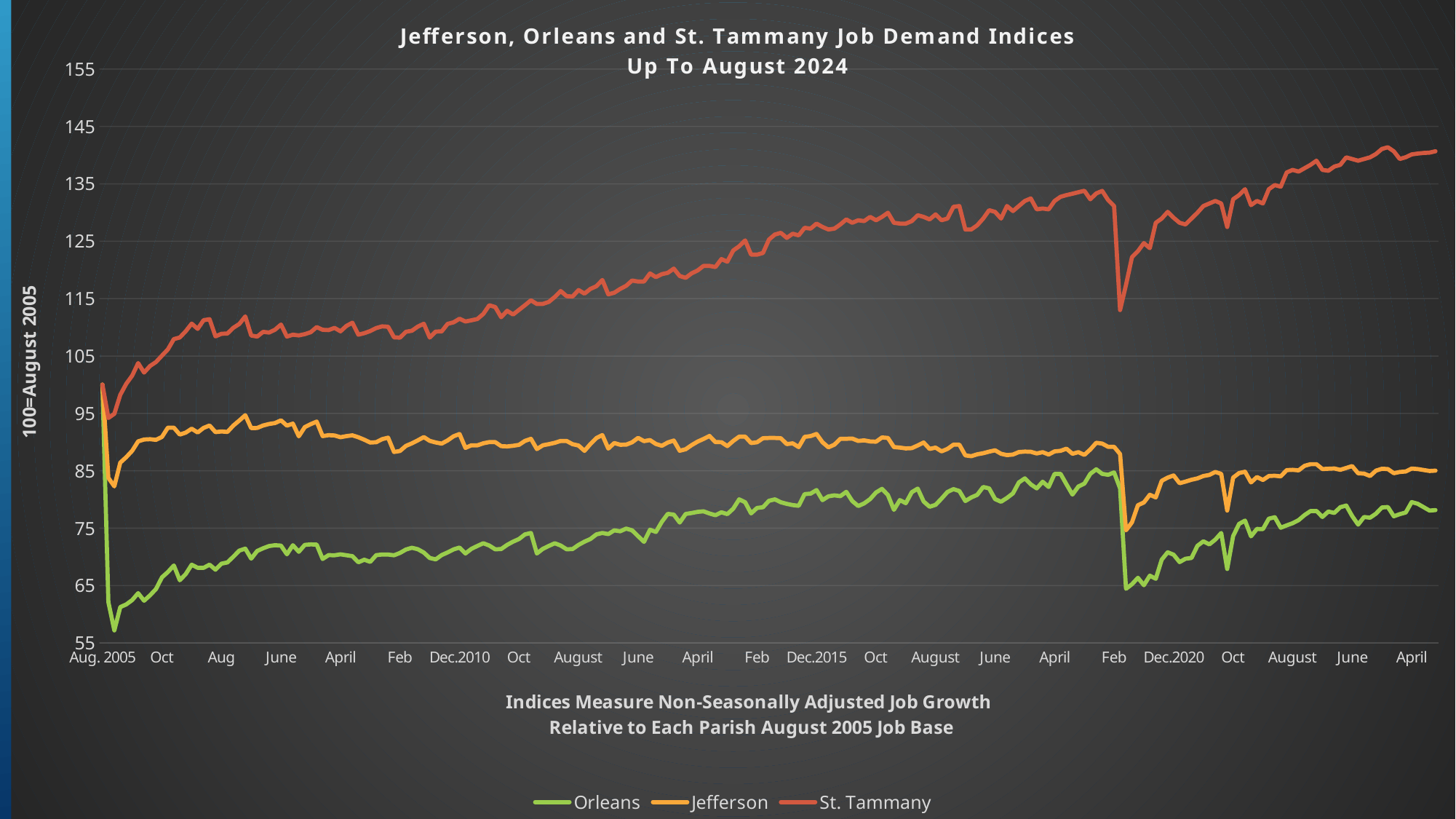
How many series does the legend list? 3 Does the St. Tammany line rise or fall from Aug. 2005 to April 2024? Rises Is the Orleans value at the end of the series (April 2024) greater or less than 85? less Which series has the lowest values across the chart? Orleans Is the St. Tammany value at the end of the series (April 2024) greater or less than 135? greater Is the lowest Orleans value, reached shortly after Aug. 2005, greater or less than 65? less Which series has the highest values across the chart? St. Tammany At Dec.2015, which is larger, the Jefferson value or the Orleans value? Jefferson What kind of chart is shown on the slide? Line chart What is the title of the chart? Jefferson, Orleans and St. Tammany Job Demand Indices Up To August 2024 Which parishes are listed in the legend? Orleans, Jefferson, St. Tammany